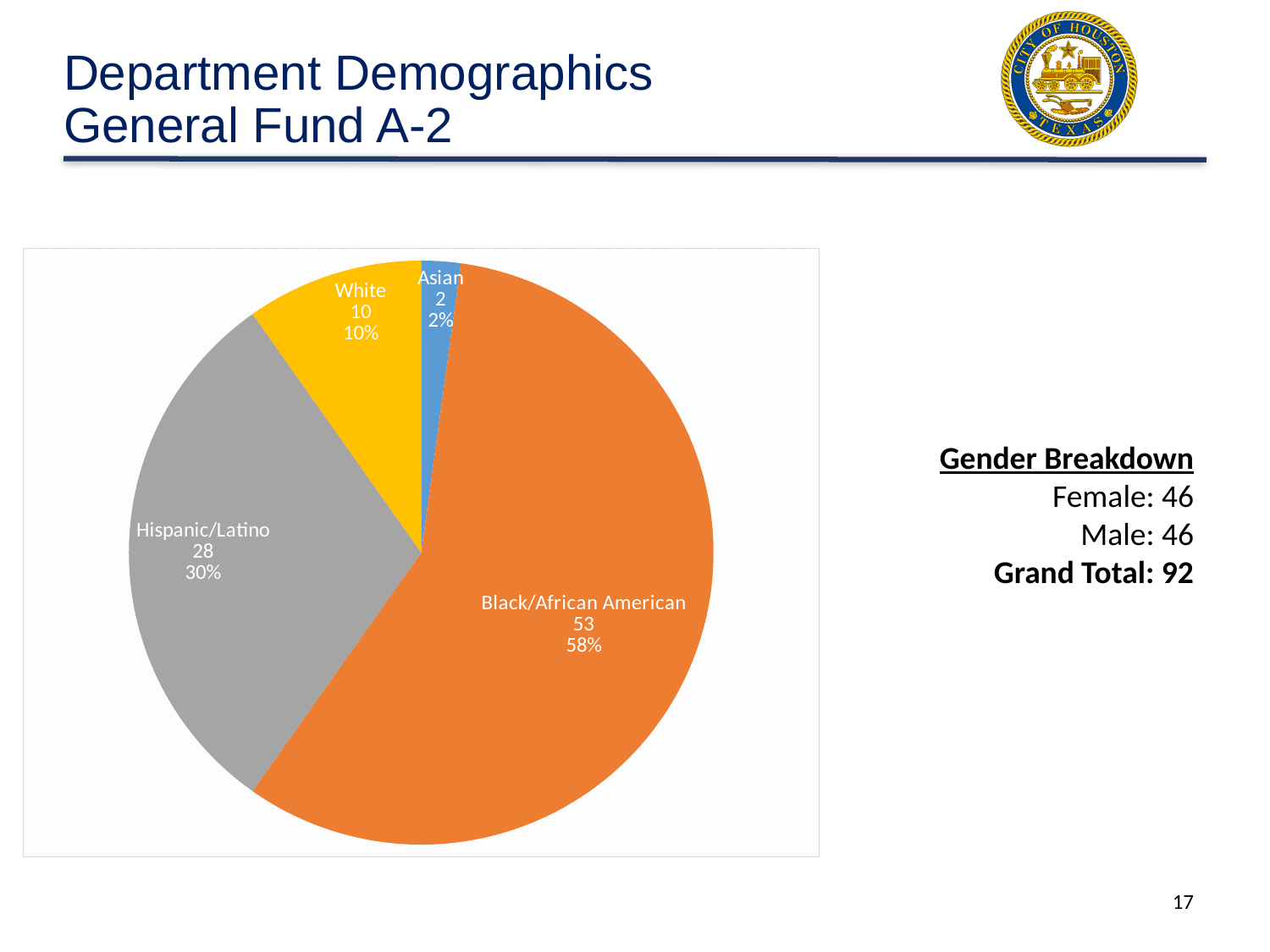
What is the value for Asian in the pie chart? 2 What share of the pie does White represent? 10% Which category has the smallest slice in the pie chart? Asian What is the value for Hispanic/Latino in the pie chart? 28 What kind of chart is shown on the slide? Pie chart What is the value for Black/African American in the pie chart? 53 What is the value for White in the pie chart? 10 What is the difference between the Black/African American value and the Hispanic/Latino value? 25 What share of the pie does Hispanic/Latino represent? 30% How many slices does the pie chart have? 4 Which category has the largest slice in the pie chart? Black/African American Which is larger in the pie chart, White or Asian? White